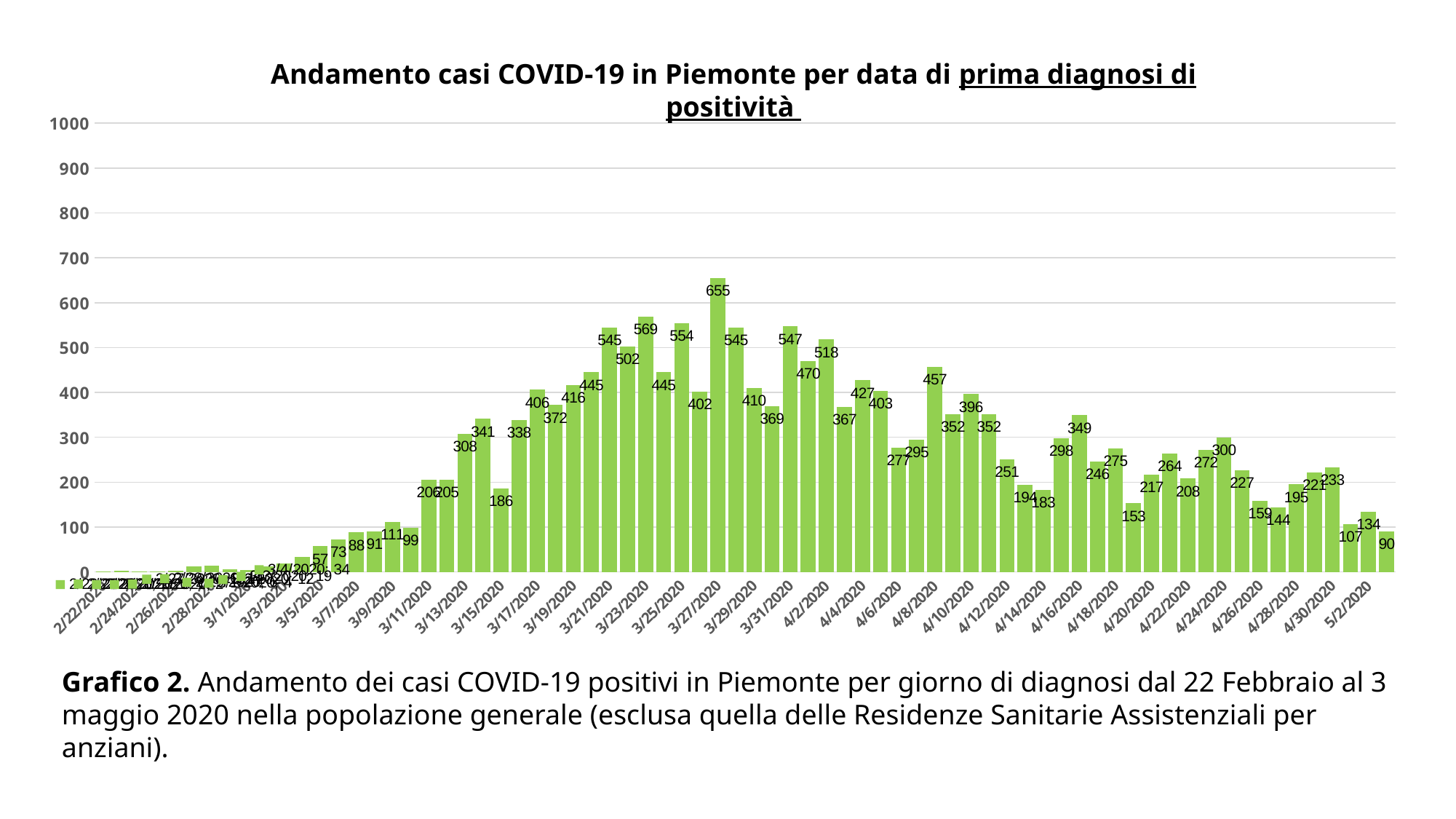
What is the value shown for 4/30/2020? 233 Which date has the larger value, 3/23/2020 or 3/25/2020? 3/23/2020 What is the title of the chart? Andamento casi COVID-19 in Piemonte per data di prima diagnosi di positività What is the value shown for 5/2/2020? 134 What is the difference between the values for 3/27/2020 and 3/28/2020? 110 What is the value shown for 3/13/2020? 308 What is the value shown for 3/27/2020? 655 What kind of chart is shown on the slide? bar chart Is the value for 4/2/2020 greater or less than 500? greater What is the value shown for 4/8/2020? 457 Do the values generally rise or fall from 3/7/2020 to 3/13/2020? rise On which date does the chart show the highest number of cases? 3/27/2020